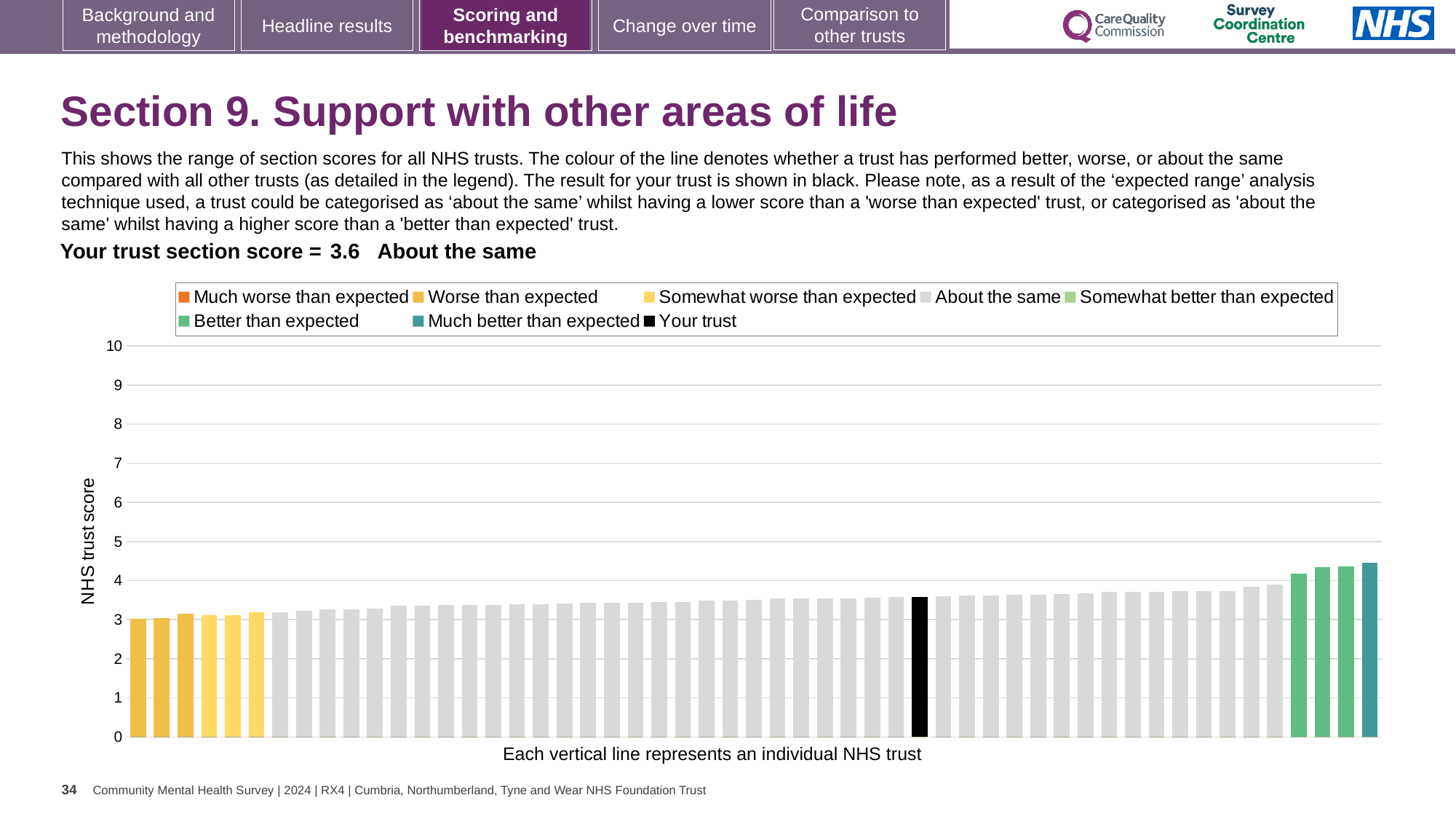
Which legend category does the shortest bar belong to? Worse than expected Is the value of the shortest bar in the chart greater or less than 4? less What is the label on the vertical axis of the chart? NHS trust score What kind of chart is shown on the slide? bar chart Do the bar values rise or fall from left to right along the x axis? rise What is the section score for 'Your trust' shown on the slide? 3.6 Is the black 'Your trust' bar taller or shorter than the rightmost bar? shorter How many entries does the chart legend list? 8 Which category is 'Your trust' placed in according to the slide? About the same Is the value of the 'Your trust' bar greater or less than 3? greater Which legend category does the tallest bar belong to? Much better than expected Is the value of the tallest bar in the chart greater or less than 5? less